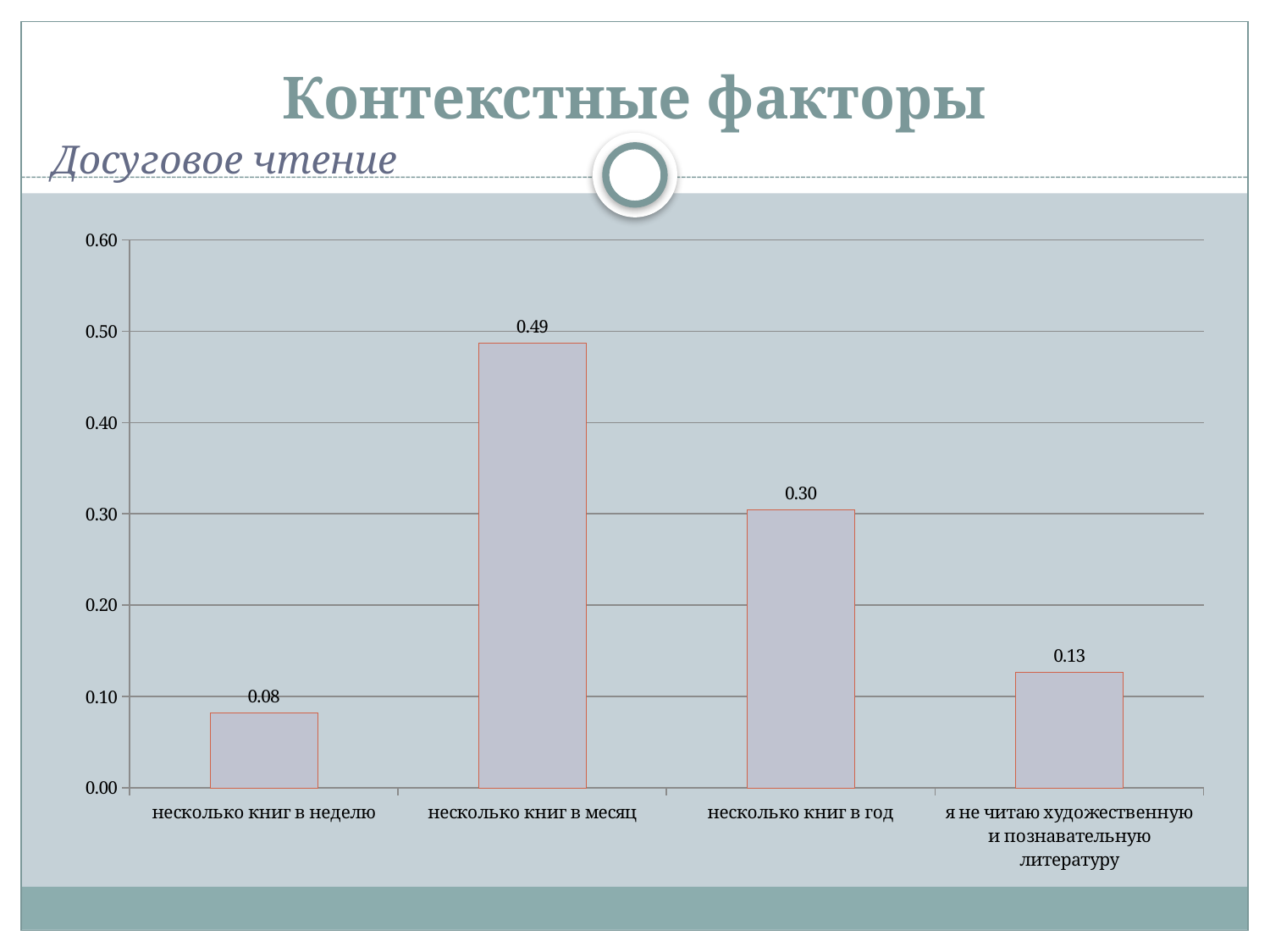
How many categories are shown on the x axis? 4 What kind of chart is shown on the slide? bar chart What is the value for "несколько книг в месяц"? 0.49 What is the subtitle shown above the chart? Досуговое чтение Which category has the highest value? несколько книг в месяц What is the value for "несколько книг в год"? 0.30 What is the value for "несколько книг в неделю"? 0.08 Is the value for "несколько книг в месяц" greater or less than 0.40? greater Which is larger: the value for "несколько книг в год" or for "я не читаю художественную и познавательную литературу"? несколько книг в год Which category has the lowest value? несколько книг в неделю What is the value for "я не читаю художественную и познавательную литературу"? 0.13 What is the difference between the values for "несколько книг в месяц" and "несколько книг в год"? 0.19